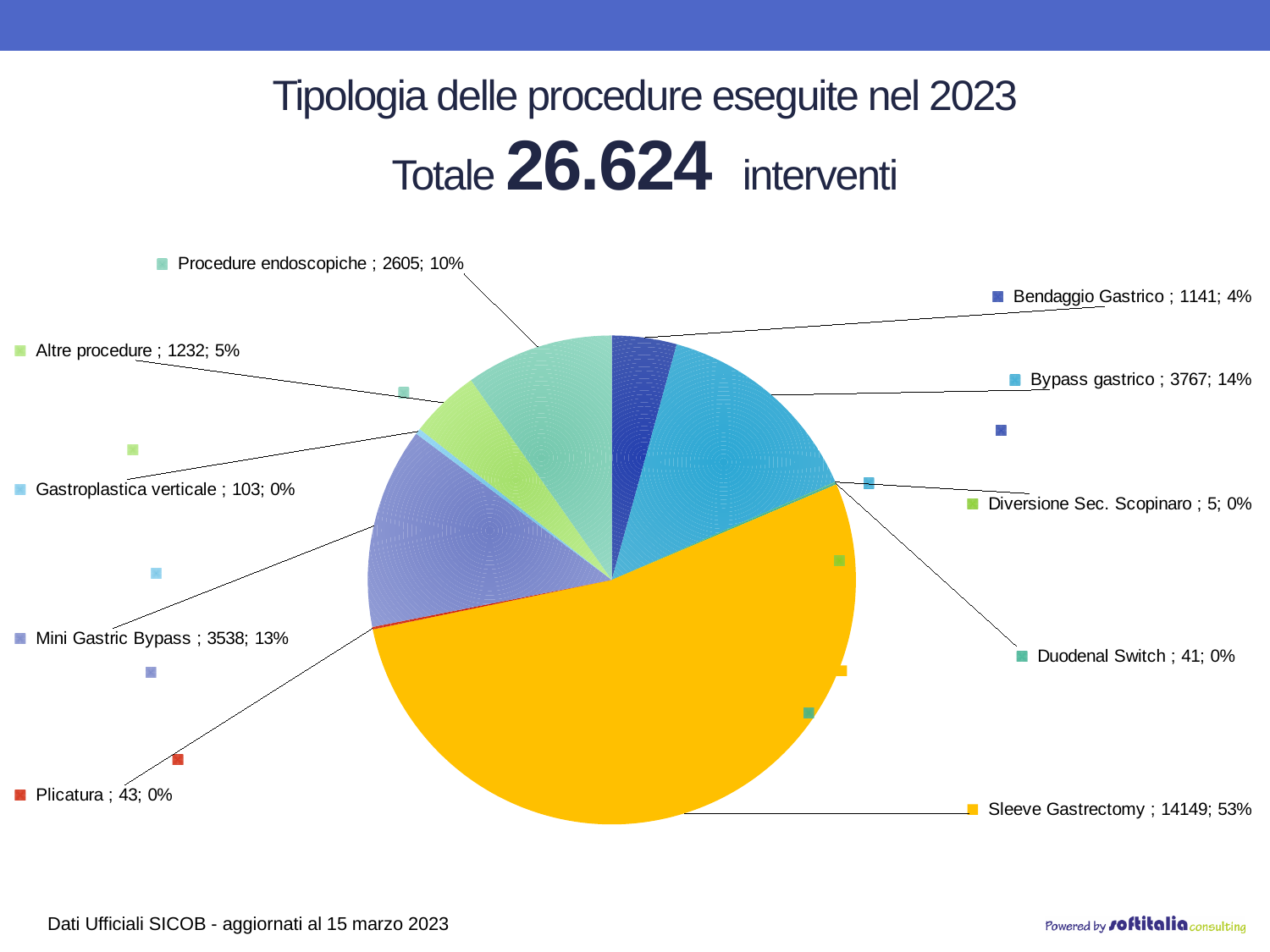
What total number of interventions is stated in the chart title? 26.624 How many procedure categories are shown in the pie chart? 10 How many interventions are shown for Sleeve Gastrectomy? 14149 Which procedure has the smallest value in the chart? Diversione Sec. Scopinaro What percentage is shown for Mini Gastric Bypass? 13% What kind of chart is shown on the slide? pie chart Which procedure has the largest slice of the pie? Sleeve Gastrectomy What share of the pie does Sleeve Gastrectomy represent? 53% What is the difference between the values for Bypass gastrico and Mini Gastric Bypass? 229 How many interventions are shown for Plicatura? 43 Which has a larger value, Procedure endoscopiche or Altre procedure? Procedure endoscopiche How many interventions are shown for Bypass gastrico? 3767